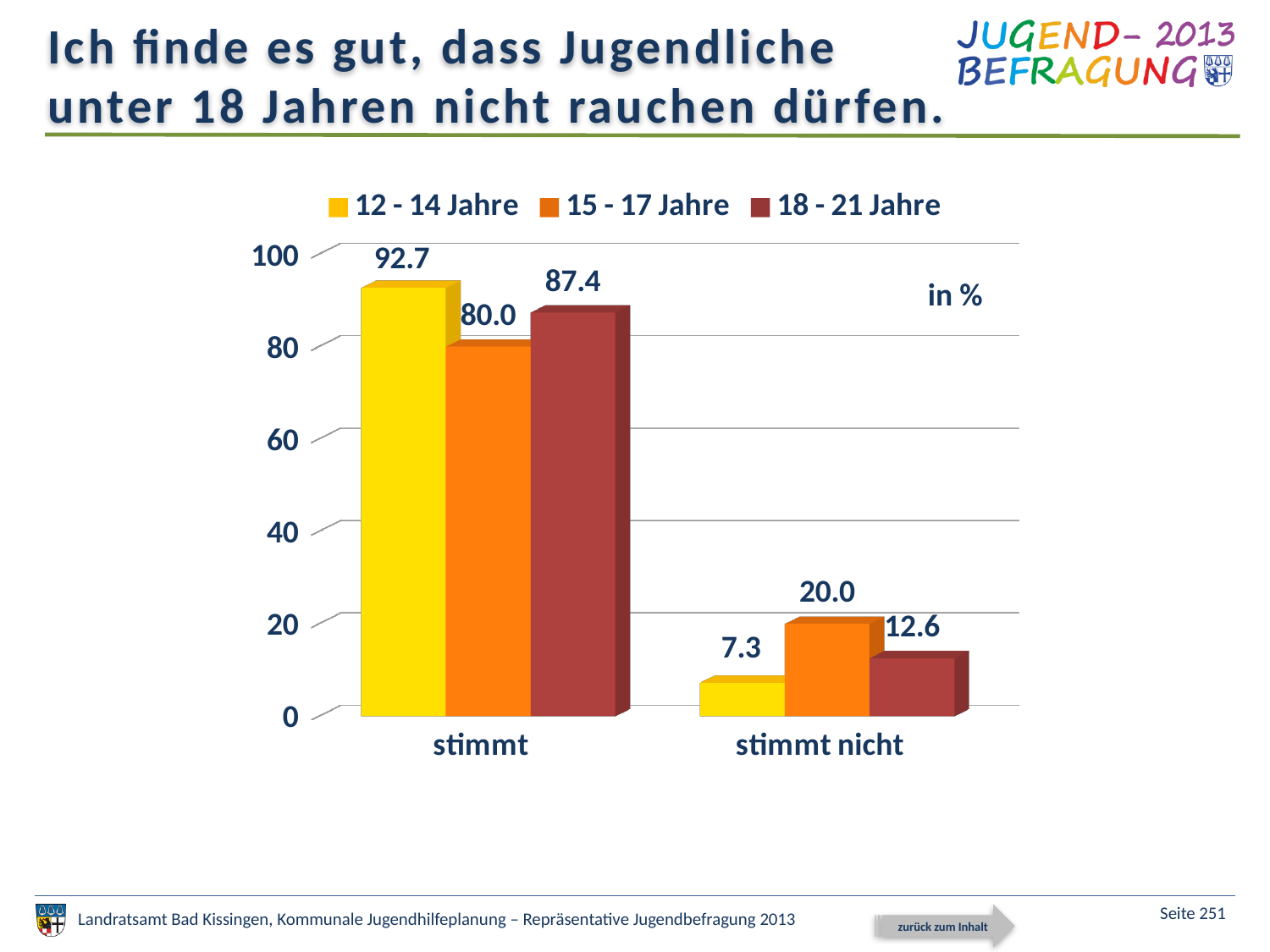
How many series does the legend list? 3 How many categories are shown on the x axis? 2 Which age group has the lowest value in the 'stimmt nicht' category? 12 - 14 Jahre Which is larger in the 'stimmt nicht' category: the value for 15 - 17 Jahre or for 18 - 21 Jahre? 15 - 17 Jahre What unit is indicated for the values in the chart? % What kind of chart is shown on the slide? bar chart Is the value for 18 - 21 Jahre in the 'stimmt nicht' category greater or less than 20? less What is the value for the 18 - 21 Jahre series in the 'stimmt' category? 87.4 What is the difference between the 12 - 14 Jahre and 15 - 17 Jahre values in the 'stimmt' category? 12.7 What is the value for the 15 - 17 Jahre series in the 'stimmt nicht' category? 20.0 Which age group has the highest value in the 'stimmt' category? 12 - 14 Jahre What is the value for the 12 - 14 Jahre series in the 'stimmt' category? 92.7